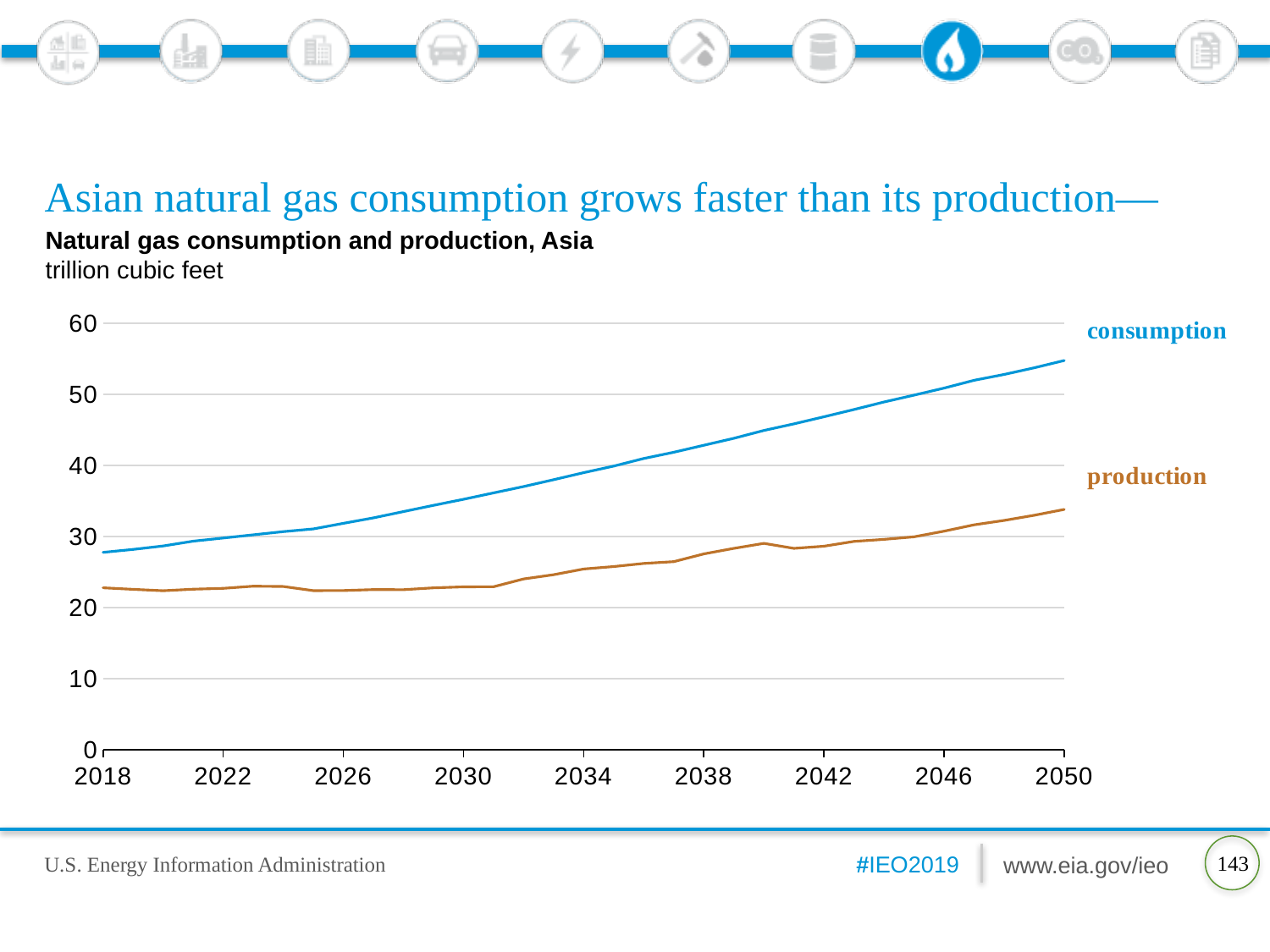
Is the value for consumption in 2034 greater or less than 30? greater Is the value for consumption in 2018 greater or less than 30? less Is the value for consumption in 2050 greater or less than 50? greater What are the two series plotted on the chart? consumption and production Which series is higher in 2050, consumption or production? consumption What unit is used on the chart's y axis? trillion cubic feet How many series does the chart show? 2 What kind of chart is shown on the slide? line chart Does consumption rise or fall from 2018 to 2050? rise Which series is lower throughout the period shown? production